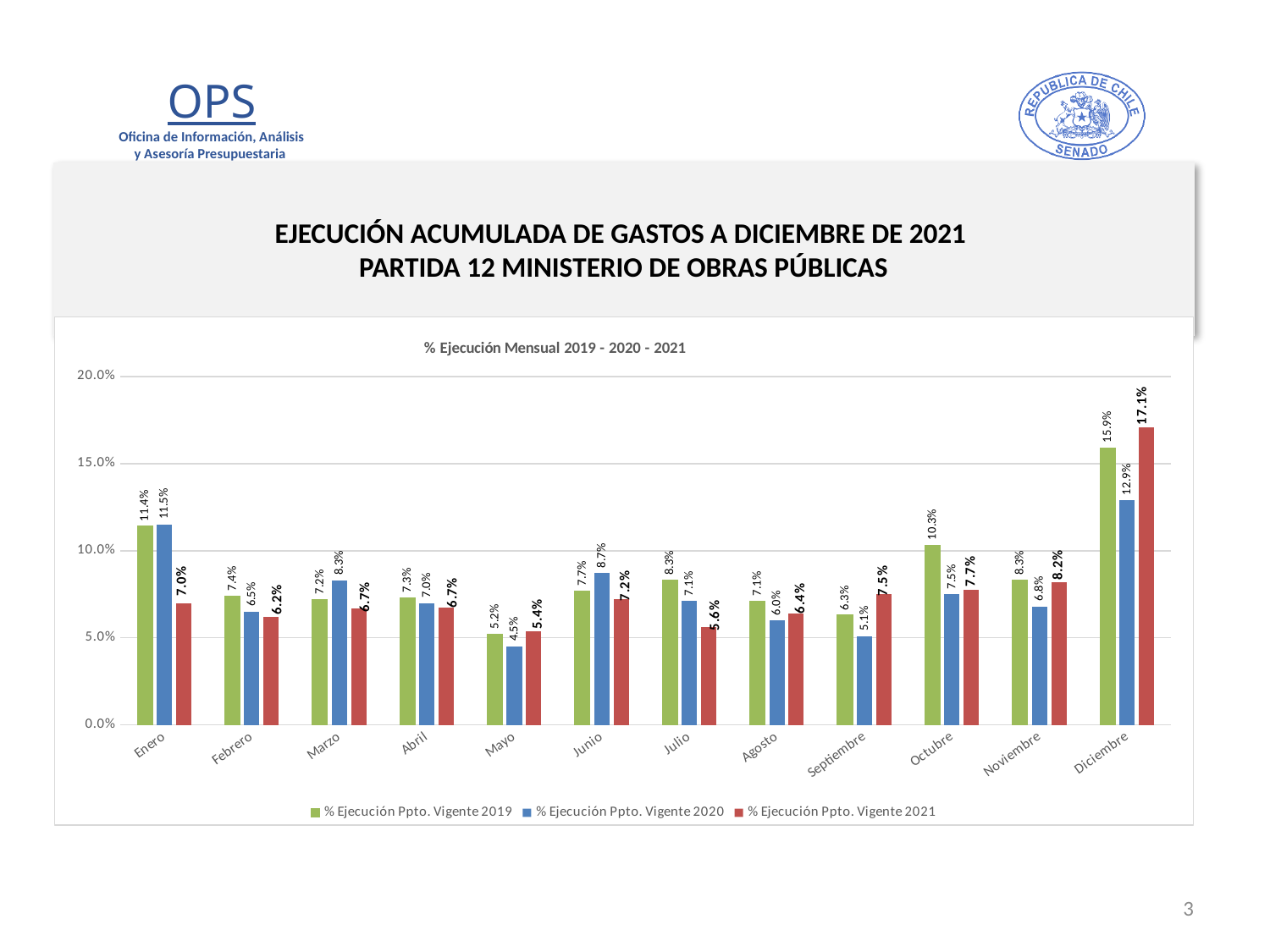
What is the value for Octubre in the % Ejecución Ppto. Vigente 2019 series? 10.3% How many series does the legend list? 3 Which month has the lowest value in the % Ejecución Ppto. Vigente 2020 series? Mayo Which is larger for Septiembre: the 2019 value or the 2021 value? 2021 value (7.5%) What is the difference between the 2021 and 2020 values for Diciembre? 4.2% What is the value for Diciembre in the % Ejecución Ppto. Vigente 2021 series? 17.1% What kind of chart is shown on the slide? Bar chart What is the title of the chart? % Ejecución Mensual 2019 - 2020 - 2021 How many months are shown on the x axis? 12 Which month has the highest value in the % Ejecución Ppto. Vigente 2021 series? Diciembre Is the value for Enero in the 2019 series greater or less than 10.0%? greater What is the value for Mayo in the % Ejecución Ppto. Vigente 2020 series? 4.5%